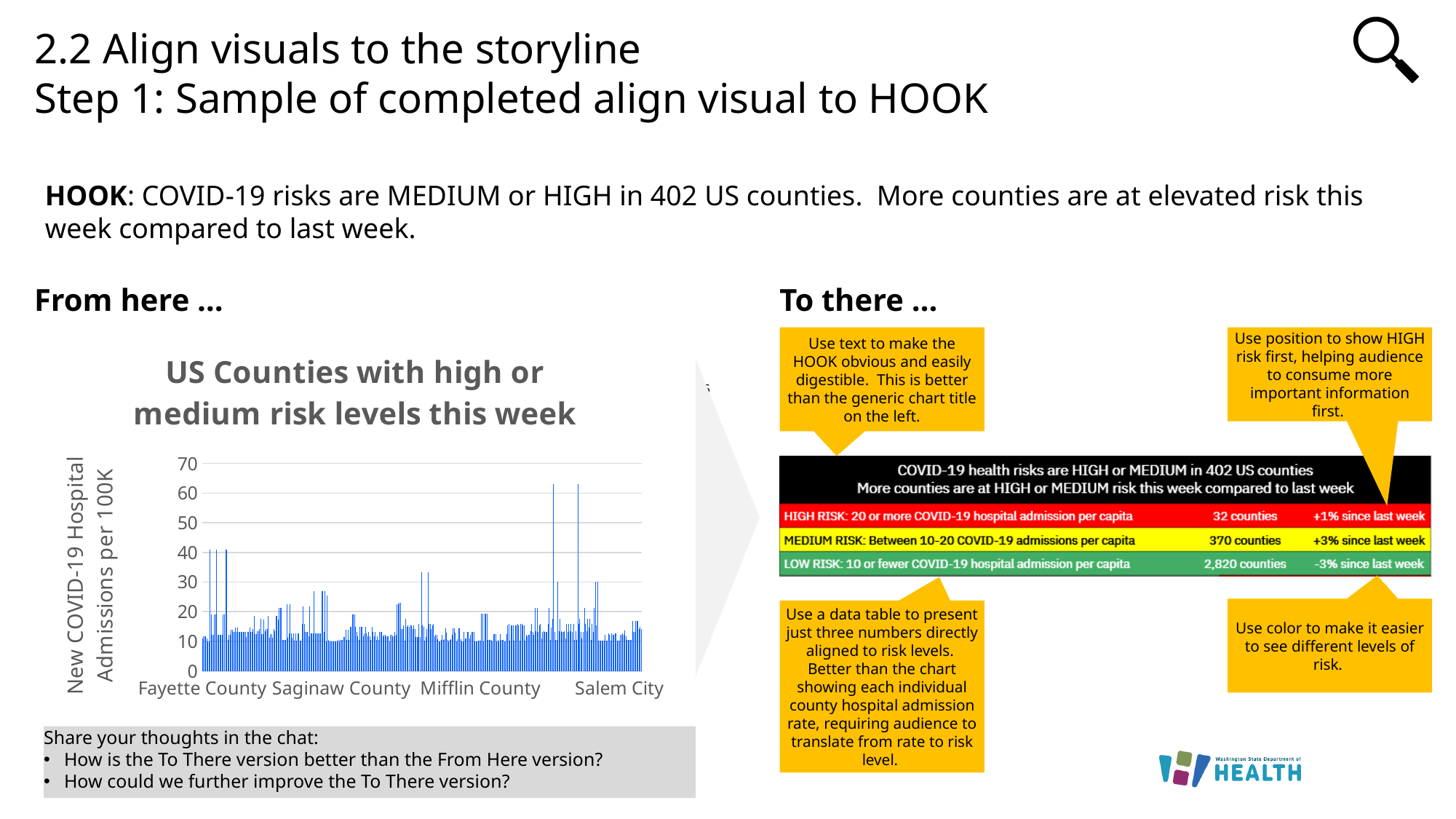
What kind of chart is shown under "From here ..." on the left of the slide? bar chart In the chart on the left, is the value of the tallest bar greater or less than 50? greater What is the title of the chart on the left of the slide? US Counties with high or medium risk levels this week What is the label on the vertical axis of the chart on the left? New COVID-19 Hospital Admissions per 100K In the chart on the left, is the value of the tallest bar greater or less than 70? less How many category labels are printed along the horizontal axis of the chart on the left? 4